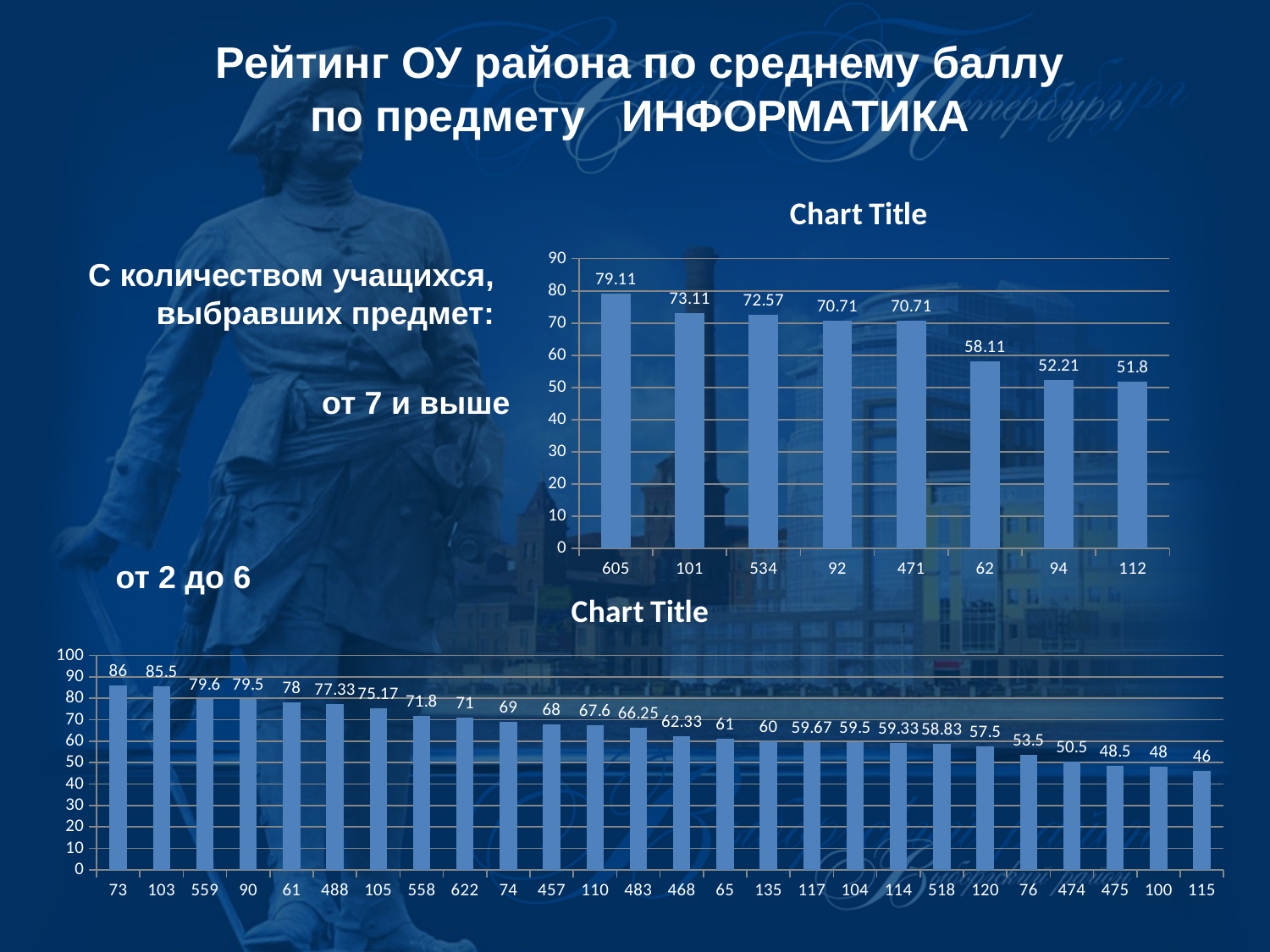
In the upper chart, which category has the lowest value? 112 In the upper chart, what is the difference between the values for 605 and 101? 6 In the upper chart, what is the value for category 62? 58.11 In the upper chart, do the values rise or fall from left to right? fall In the upper chart, what is the value for category 605? 79.11 What type of chart is the lower chart? bar chart In the lower chart, what is the value for category 73? 86 In the lower chart, which is larger: the value for 559 or the value for 488? 559 In the lower chart, what is the value for category 518? 58.83 In the lower chart, how many bars are plotted? 26 In the lower chart, which category has the lowest value? 115 In the upper chart, how many bars are plotted? 8